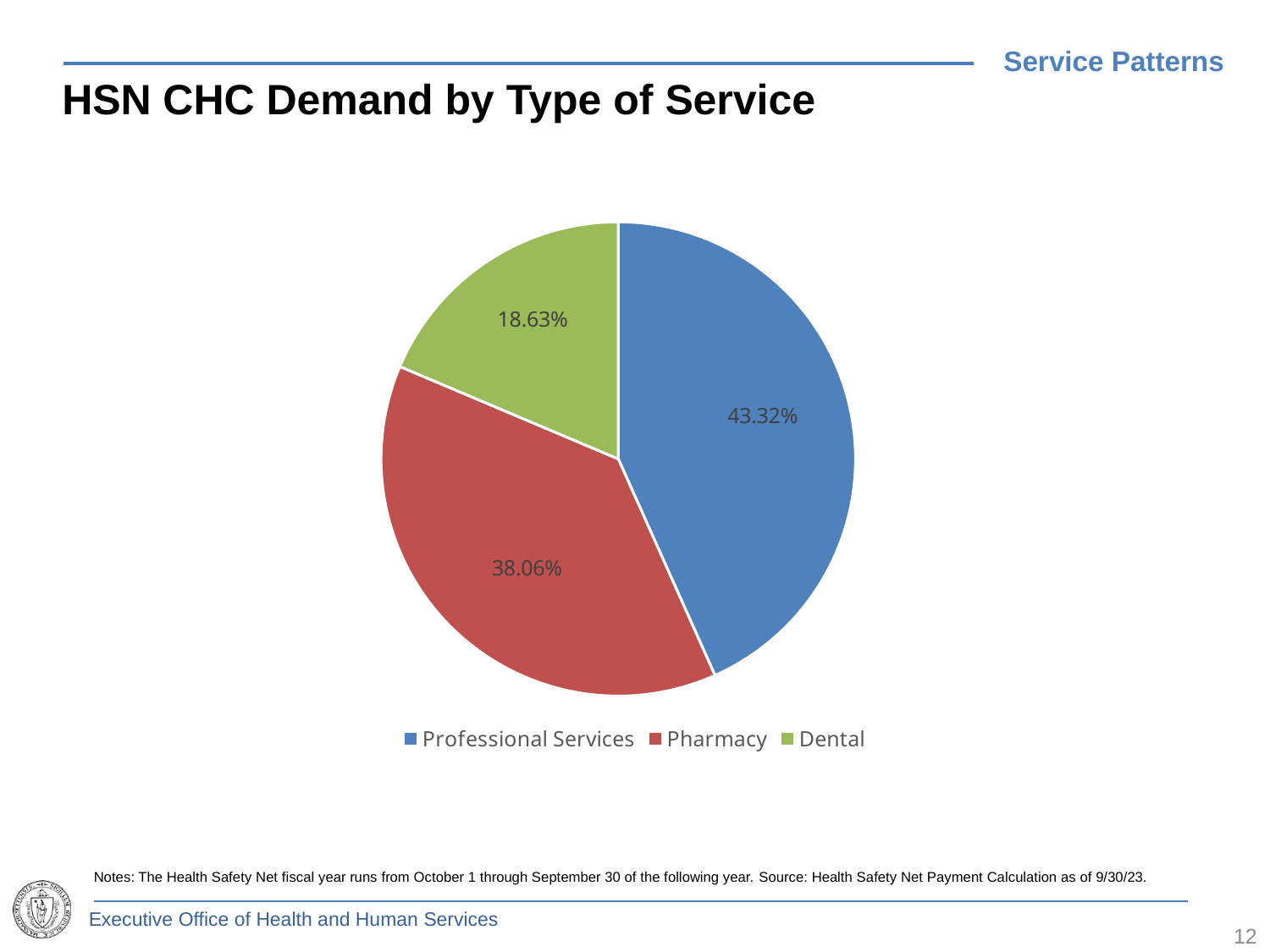
Which type of service has the smallest share of HSN CHC demand? Dental How many types of service are shown in the pie chart? 3 Which has a larger share of HSN CHC demand, Pharmacy or Dental? Pharmacy Which colour represents Pharmacy in the pie chart? Red What share of HSN CHC demand is Pharmacy? 38.06% What kind of chart is shown on the slide? Pie chart What is the difference in percentage points between the Professional Services and Pharmacy shares? 5.26 What share of HSN CHC demand is Dental? 18.63% What share of HSN CHC demand is Professional Services? 43.32% What is the title of the chart on the slide? HSN CHC Demand by Type of Service Which type of service has the largest share of HSN CHC demand? Professional Services What is the difference in percentage points between the Pharmacy and Dental shares? 19.43